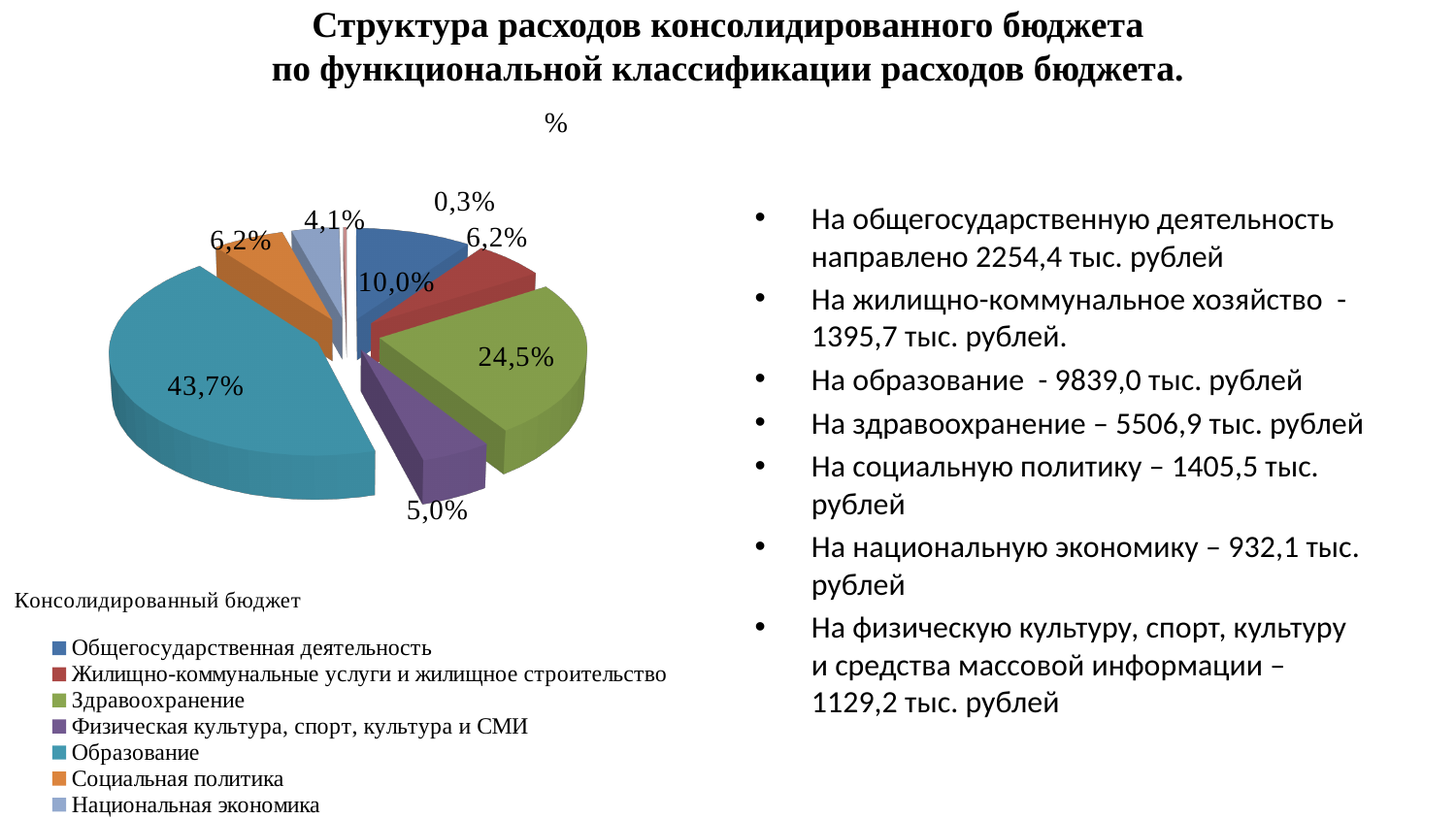
Which has a larger share: Здравоохранение or Общегосударственная деятельность? Здравоохранение How many categories are listed in the chart legend? 7 By how many percentage points does the share of Образование exceed the share of Здравоохранение? 19,2 What percentage share does Здравоохранение have in the pie chart? 24,5% What percentage share does Социальная политика have in the pie chart? 6,2% What is the smallest percentage value labelled on the pie chart? 0,3% What percentage share does Физическая культура, спорт, культура и СМИ have in the pie chart? 5,0% What kind of chart is shown on the slide? Pie chart What percentage share does Общегосударственная деятельность have in the pie chart? 10,0% What percentage share does Образование have in the pie chart? 43,7% What percentage share does Национальная экономика have in the pie chart? 4,1% Which category has the largest slice in the pie chart? Образование